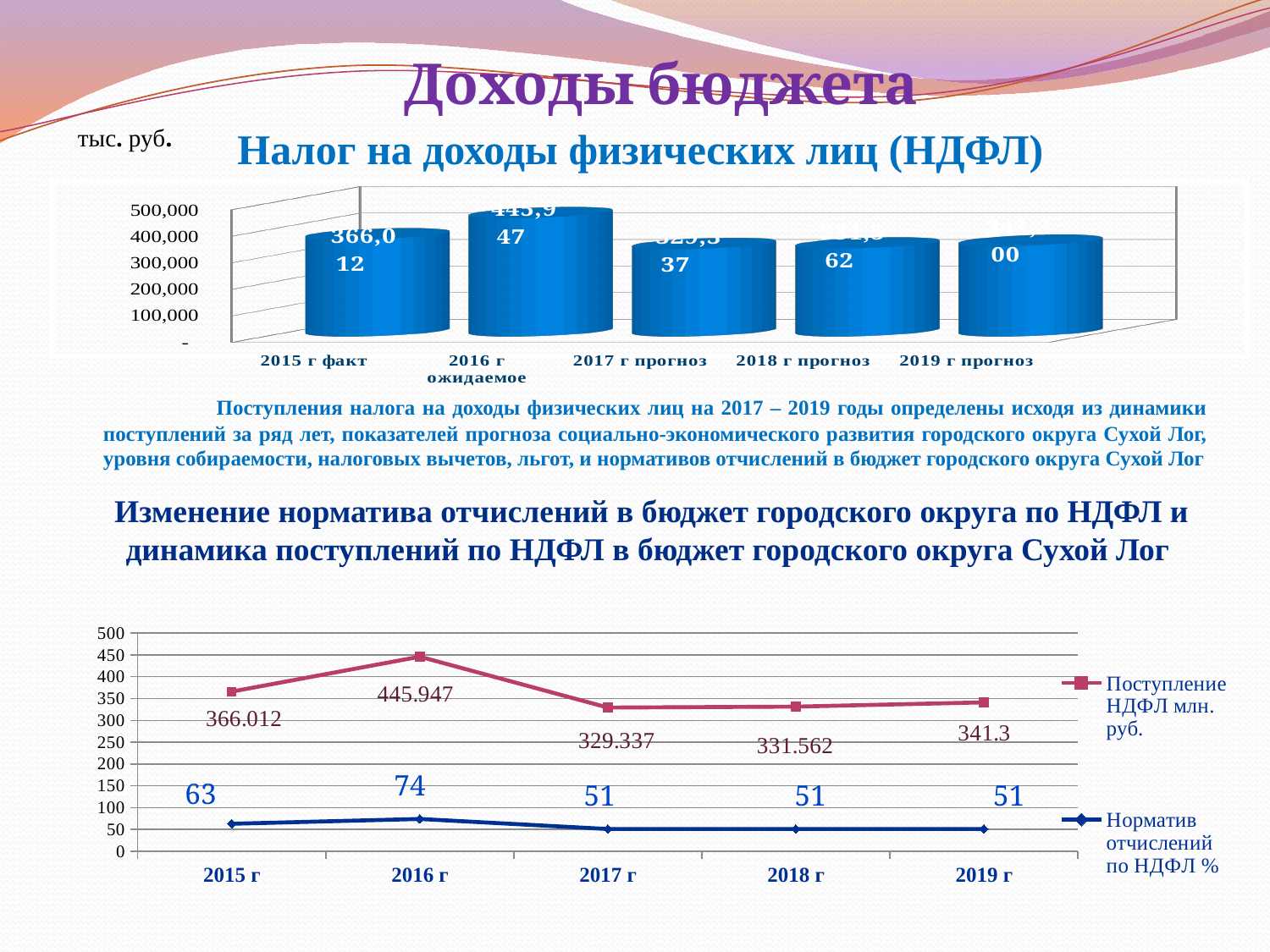
On the top chart 'Налог на доходы физических лиц (НДФЛ)', which category has the tallest bar? 2016 г ожидаемое On the bottom line chart, what is the value of Норматив отчислений по НДФЛ % for 2015 г? 63 On the bottom line chart, what is the difference between Поступление НДФЛ млн. руб. in 2016 г and 2015 г? 79.935 On the bottom line chart, in which year is Поступление НДФЛ млн. руб. highest? 2016 г On the bottom line chart, in which year is Поступление НДФЛ млн. руб. lowest? 2017 г On the bottom line chart, by how much does Норматив отчислений по НДФЛ % fall from 2016 г to 2017 г? 23 On the bottom line chart, which is larger: Поступление НДФЛ млн. руб. in 2018 г or in 2019 г? 2019 г What kind of chart is the bottom chart on the slide? line chart How many years are shown on the x axis of the bottom line chart? 5 On the bottom line chart, what is the value of Поступление НДФЛ млн. руб. for 2016 г? 445.947 What kind of chart is the top chart titled 'Налог на доходы физических лиц (НДФЛ)'? bar chart How many series does the legend of the bottom line chart list? 2